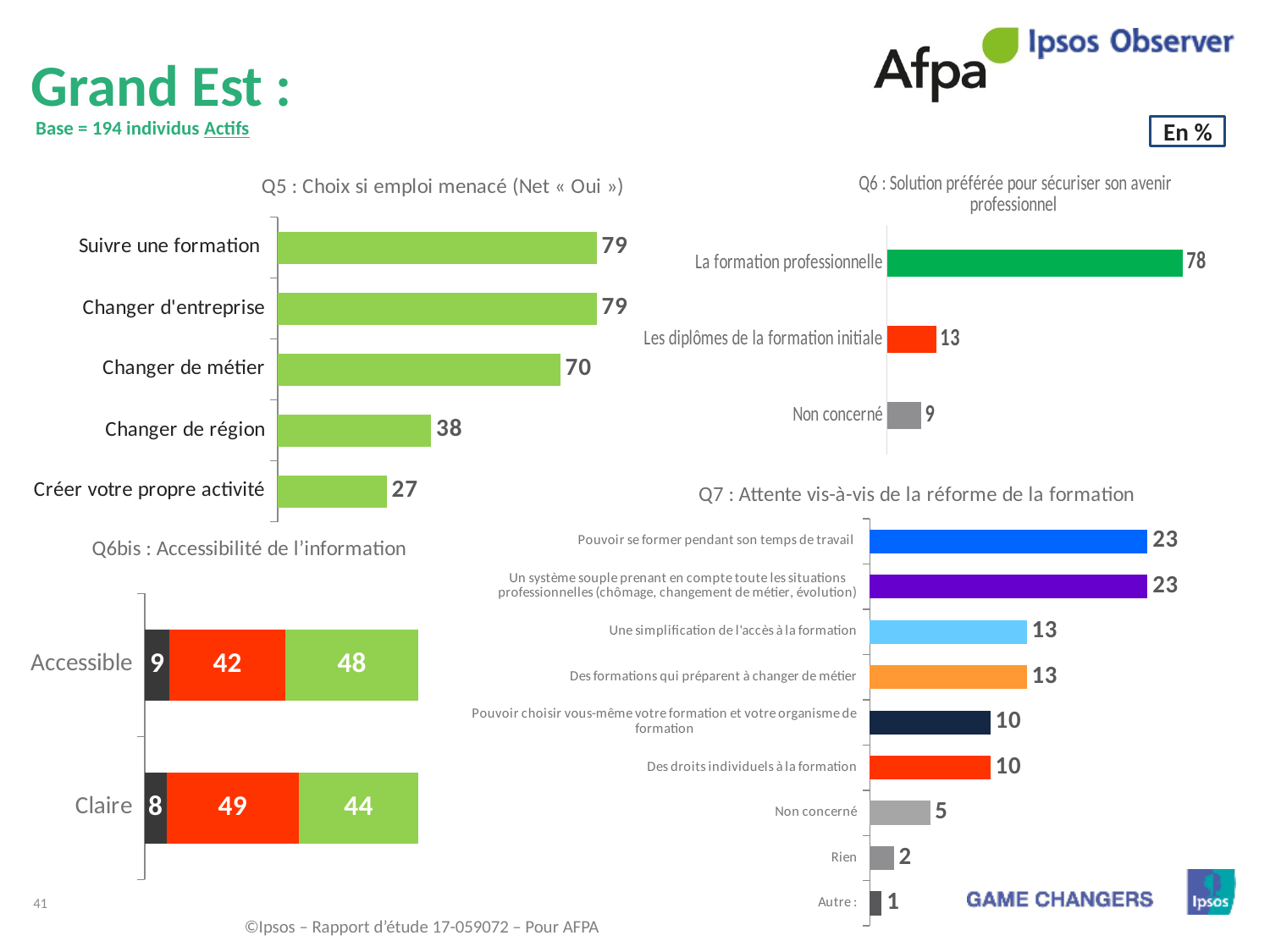
In the Q6bis chart (Accessibilité de l'information), what is the total of the Claire stacked bar? 101 In the Q5 chart (Choix si emploi menacé), how many categories are shown? 5 In the Q6 chart (Solution préférée pour sécuriser son avenir professionnel), which category has the highest value? La formation professionnelle In the Q6bis chart (Accessibilité de l'information), what is the value of the green segment for Accessible? 48 In the Q5 chart (Choix si emploi menacé), what is the value for Changer de métier? 70 In the Q5 chart (Choix si emploi menacé), what is the difference between Changer de métier and Changer de région? 32 In the Q6 chart (Solution préférée pour sécuriser son avenir professionnel), which is larger: Les diplômes de la formation initiale or Non concerné? Les diplômes de la formation initiale In the Q7 chart (Attente vis-à-vis de la réforme de la formation), what is the value for Des droits individuels à la formation? 10 In the Q7 chart (Attente vis-à-vis de la réforme de la formation), how many categories are shown? 9 In the Q6 chart (Solution préférée pour sécuriser son avenir professionnel), what is the value for La formation professionnelle? 78 What kind of chart is the Q7 chart (Attente vis-à-vis de la réforme de la formation)? Bar chart In the Q5 chart (Choix si emploi menacé), which category has the lowest value? Créer votre propre activité